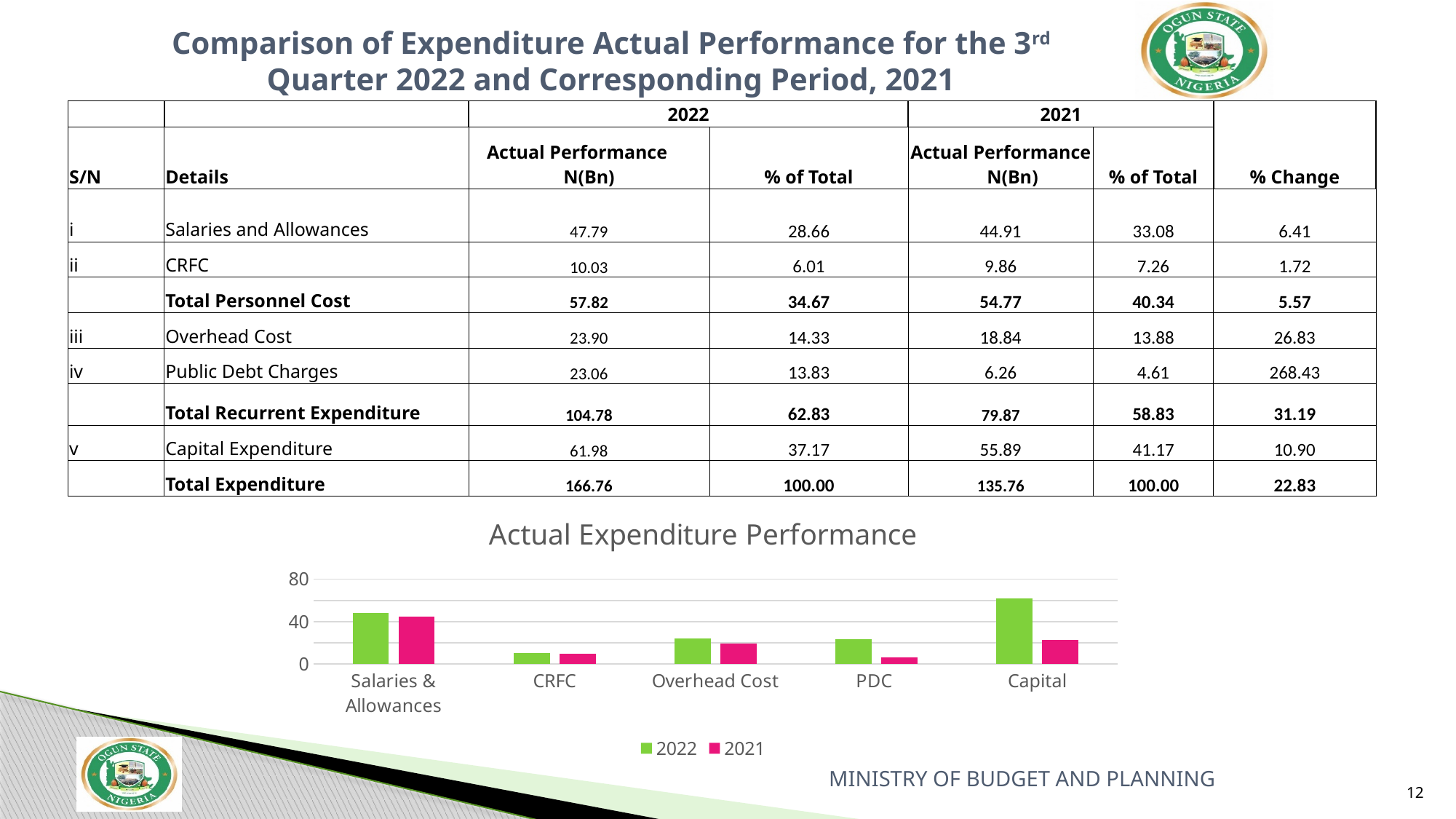
In the 'Actual Expenditure Performance' chart, which category has the lowest 2021 bar? PDC In the 'Actual Expenditure Performance' chart, is the 2021 value for CRFC greater or less than 40? less In the 'Actual Expenditure Performance' chart, which category has the highest 2022 bar? Capital What kind of chart is 'Actual Expenditure Performance'? bar chart In the 'Actual Expenditure Performance' chart, which is larger for PDC: the 2022 bar or the 2021 bar? 2022 How many series does the legend of the 'Actual Expenditure Performance' chart list? 2 In the 'Actual Expenditure Performance' chart, which colour represents the 2022 series? green According to the table on the slide, what is the 2022 Actual Performance N(Bn) for Overhead Cost plotted in the chart? 23.90 In the 'Actual Expenditure Performance' chart, is the 2022 value for Capital greater or less than 40? greater In the 'Actual Expenditure Performance' chart, is the 2022 value for Salaries & Allowances greater or less than 40? greater How many categories are shown on the x axis of the 'Actual Expenditure Performance' chart? 5 According to the table on the slide, what is the difference between the 2022 and 2021 Actual Performance N(Bn) for Capital Expenditure? 6.09